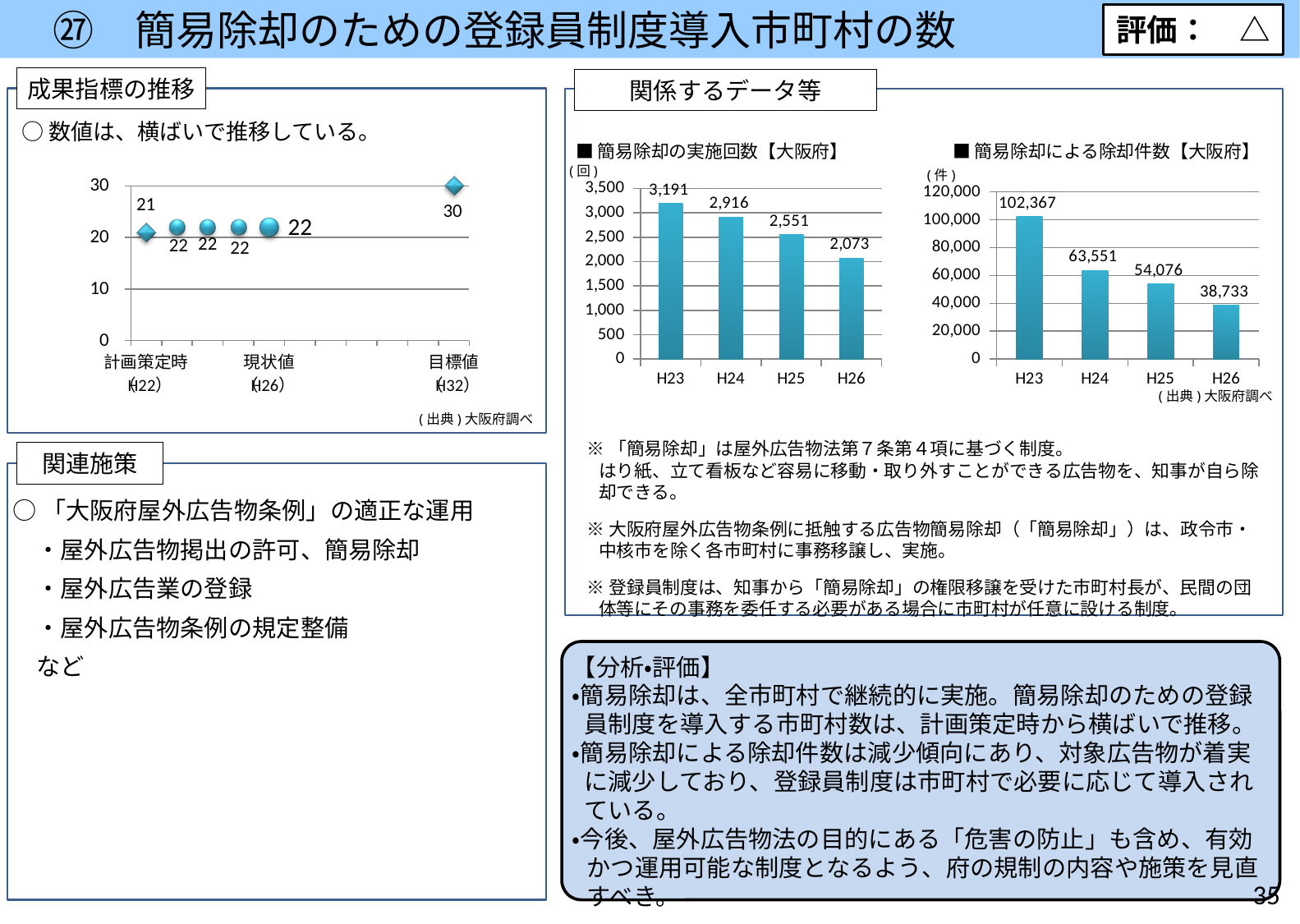
In the chart titled 簡易除却の実施回数【大阪府】, which year has the lowest value? H26 In the chart titled 簡易除却の実施回数【大阪府】, what is the value for H26? 2,073 What kind of chart is the one titled 簡易除却の実施回数【大阪府】? bar chart In the chart titled 簡易除却による除却件数【大阪府】, what is the value for H25? 54,076 In the chart titled 簡易除却による除却件数【大阪府】, which year has the highest value? H23 In the chart titled 簡易除却の実施回数【大阪府】, what is the difference between the H23 and H24 values? 275 In the chart titled 簡易除却による除却件数【大阪府】, what is the difference between the H24 and H26 values? 24,818 In the chart titled 簡易除却の実施回数【大阪府】, what is the value for H23? 3,191 In the chart titled 簡易除却の実施回数【大阪府】, do the values rise or fall from H23 to H26? fall In the chart under 成果指標の推移 on the left, what is the value for 目標値 (H32)? 30 In the chart titled 簡易除却による除却件数【大阪府】, what is the value for H23? 102,367 In the chart titled 簡易除却による除却件数【大阪府】, how many years are shown on the x axis? 4